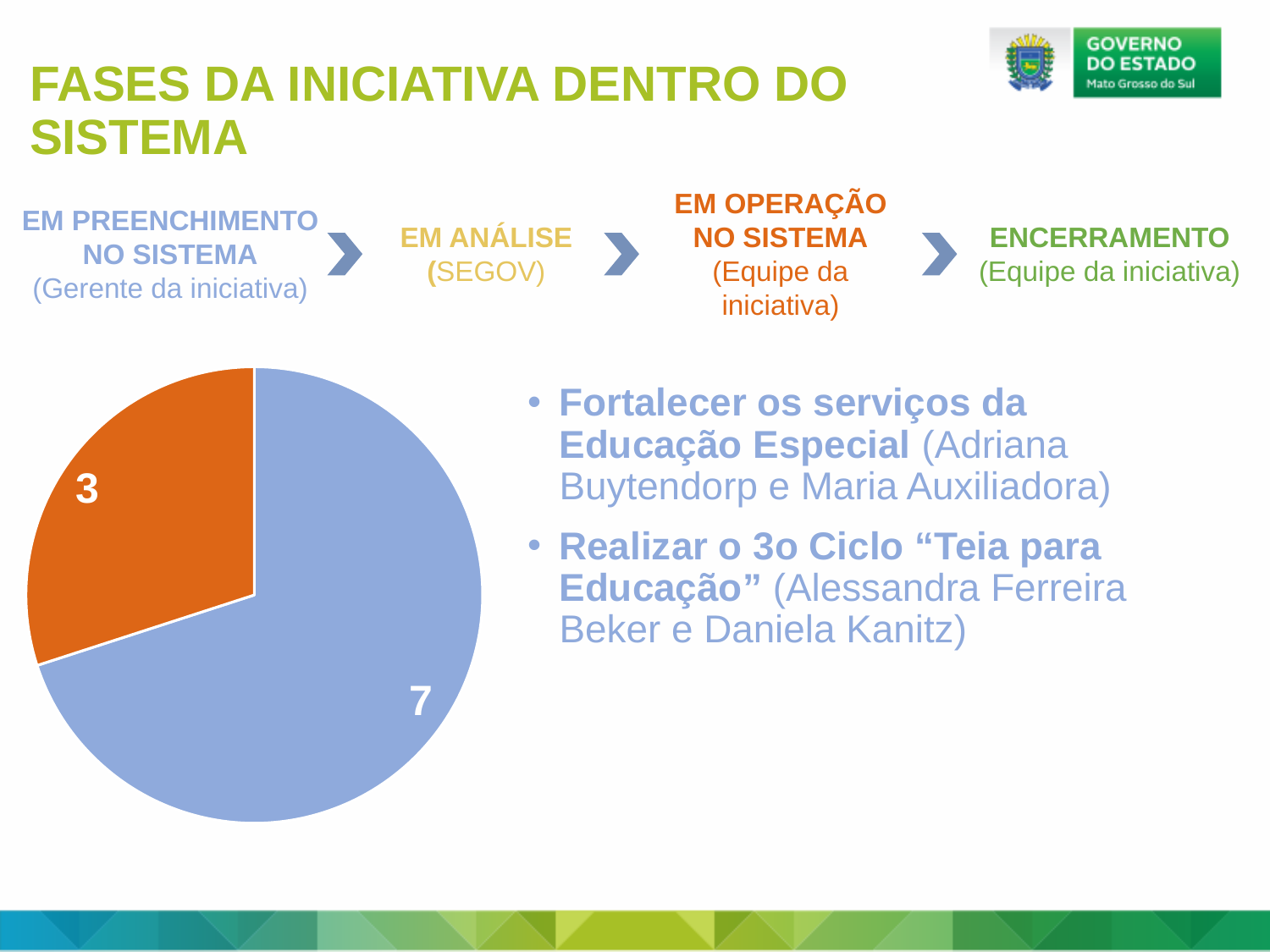
What kind of chart is shown on the slide? pie chart What share of the pie does the orange slice (3) represent? 30% What share of the pie does the blue slice (7) represent? 70% What is the difference between the blue slice and the orange slice in the pie chart? 4 What is the total of the values shown in the pie chart? 10 Which slice of the pie chart has the smallest value? the orange slice (3) How many slices does the pie chart have? 2 What value is shown on the blue slice of the pie chart? 7 Which slice of the pie chart has the largest value? the blue slice (7) What value is shown on the orange slice of the pie chart? 3 Is the blue slice or the orange slice of the pie chart larger? the blue slice Does the pie chart include a legend? No